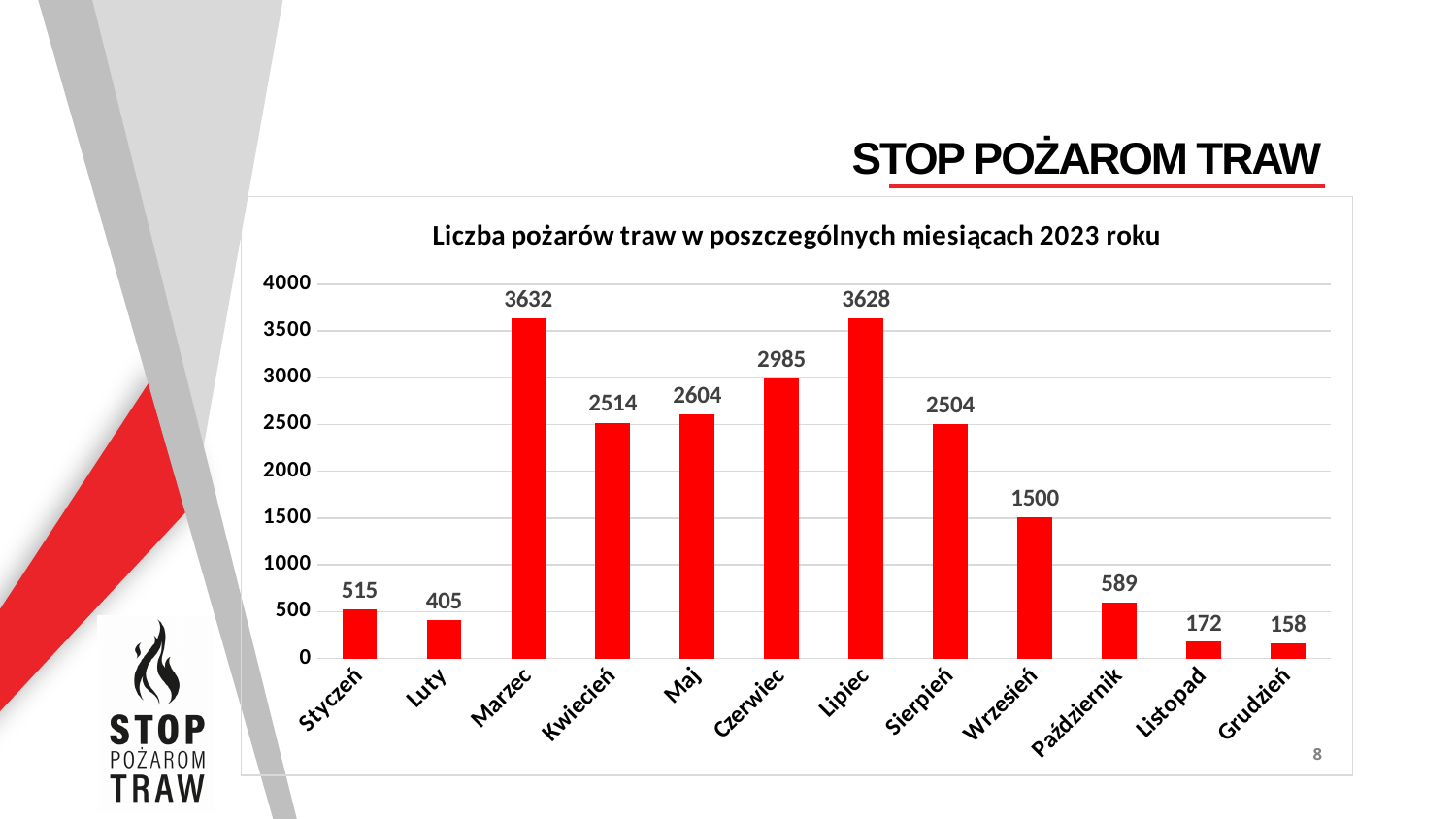
What is the value for Czerwiec? 2985 What is the difference between the values for Maj and Kwiecień? 90 Which is larger, the value for Styczeń or the value for Październik? Październik Is the value for Sierpień greater or less than 3000? less What is the value for Luty? 405 Which month has the lowest value? Grudzień What kind of chart is shown on the slide? bar chart What is the value for Wrzesień? 1500 What is the difference between the values for Marzec and Lipiec? 4 What is the title of the chart? Liczba pożarów traw w poszczególnych miesiącach 2023 roku Which month has the highest value? Marzec How many months are shown on the x axis? 12